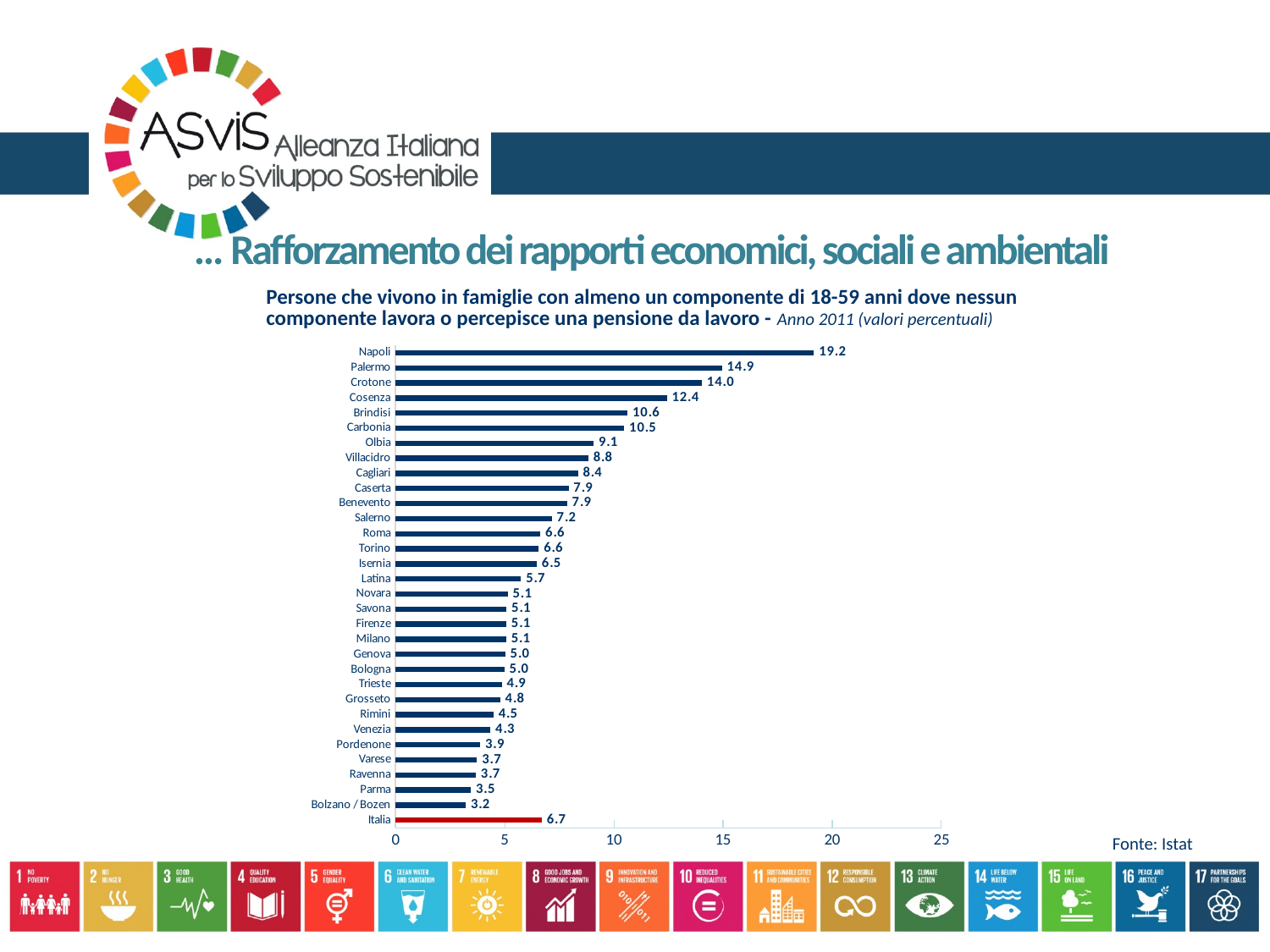
Which category has the lowest value? Bolzano / Bozen Which category has the highest value? Napoli What is the value for Italia? 6.7 What is the difference between the values for Italia and Roma? 0.1 What kind of chart is shown on the slide? Bar chart How many categories are shown in the chart? 32 Is the value for Brindisi greater or less than 10? greater What is the difference between the values for Napoli and Palermo? 4.3 What is the value for Bolzano / Bozen? 3.2 Which has a larger value, Crotone or Cosenza? Crotone What is the value for Cagliari? 8.4 What is the value for Napoli? 19.2